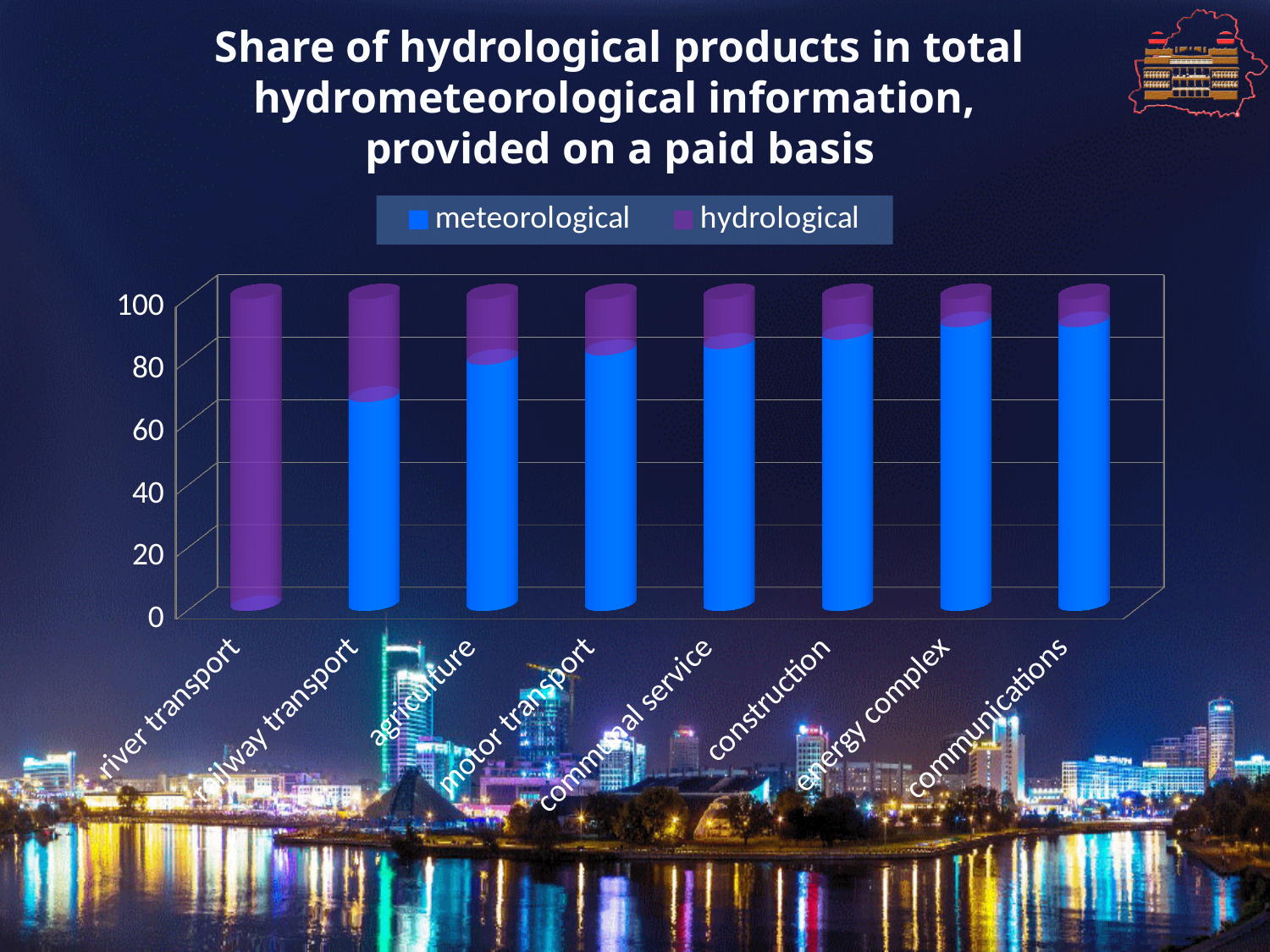
How many series does the chart's legend list? 2 Is the meteorological value for construction greater or less than 80? greater Which has the larger hydrological value, railway transport or energy complex? railway transport Is the hydrological value for railway transport greater or less than 20? greater What kind of chart is shown on the slide? bar chart Is the meteorological value for railway transport greater or less than 80? less Which series is shown in purple in the legend? hydrological How many categories are shown along the x axis of the chart? 8 Which category has the largest hydrological share? river transport Which has the larger meteorological value, railway transport or construction? construction Does the hydrological share generally rise or fall moving from river transport to communications along the x axis? fall Which category has the smallest meteorological share? river transport